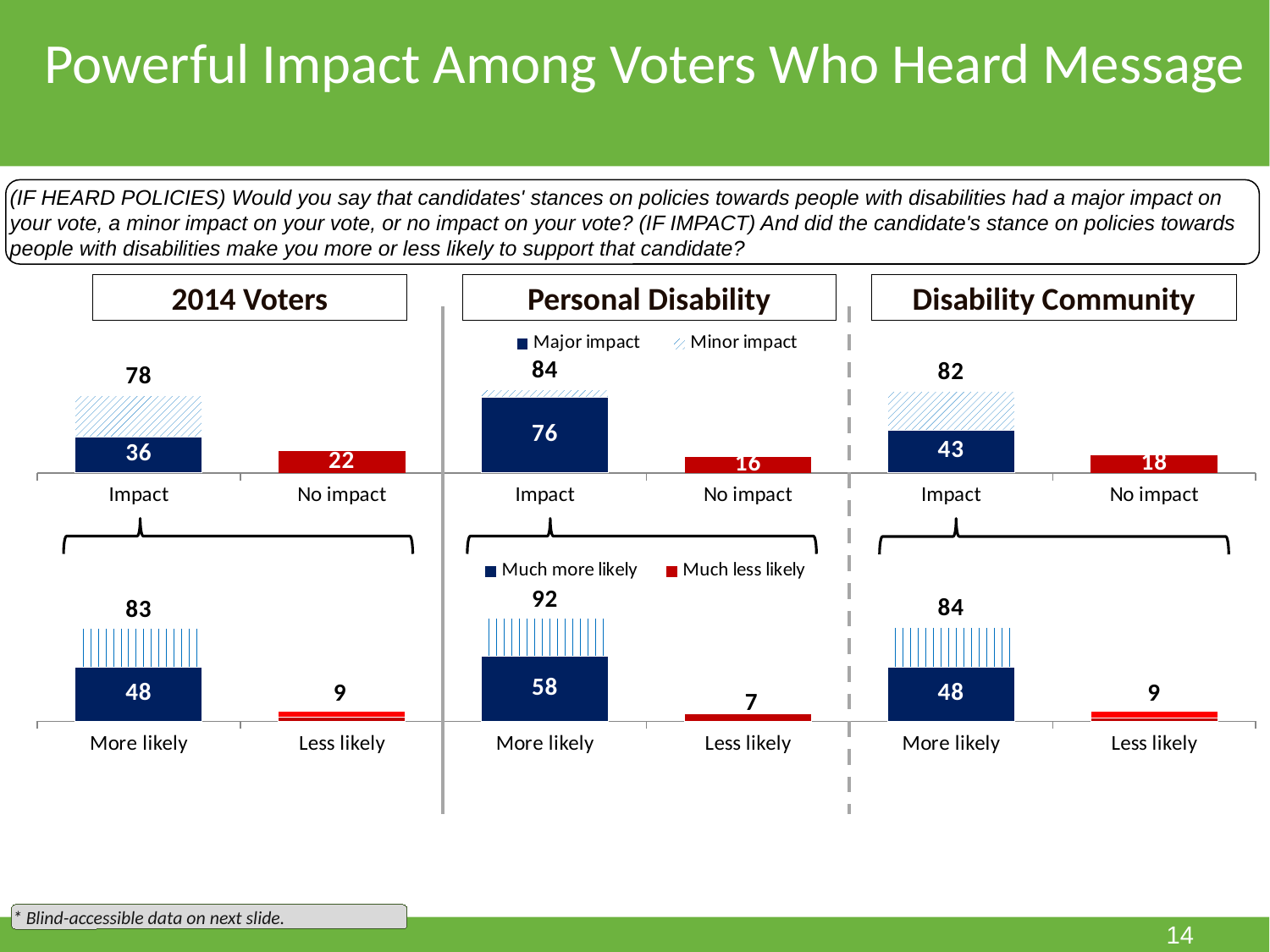
In the Personal Disability top chart, what is the value for No impact? 16 What type of chart is used in the Personal Disability top chart? Bar chart In the Personal Disability top chart, what is the difference between the Impact total and the No impact value? 68 Across the three bottom charts, which group has the lowest Less likely value? Personal Disability In the 2014 Voters top chart, what is the total value of the Impact bar? 78 In the Disability Community bottom chart, what is the total value of the More likely bar? 84 In the Personal Disability bottom chart, what is the Much more likely value? 58 How many series does the legend above the Personal Disability top chart list? 2 Across the three bottom charts, which group has the highest More likely total? Personal Disability In the 2014 Voters top chart, what is the Minor impact portion of the Impact bar (Impact total minus Major impact)? 42 In the 2014 Voters top chart, what is the Major impact value for the Impact bar? 36 In the Disability Community top chart, which is larger, Impact or No impact? Impact